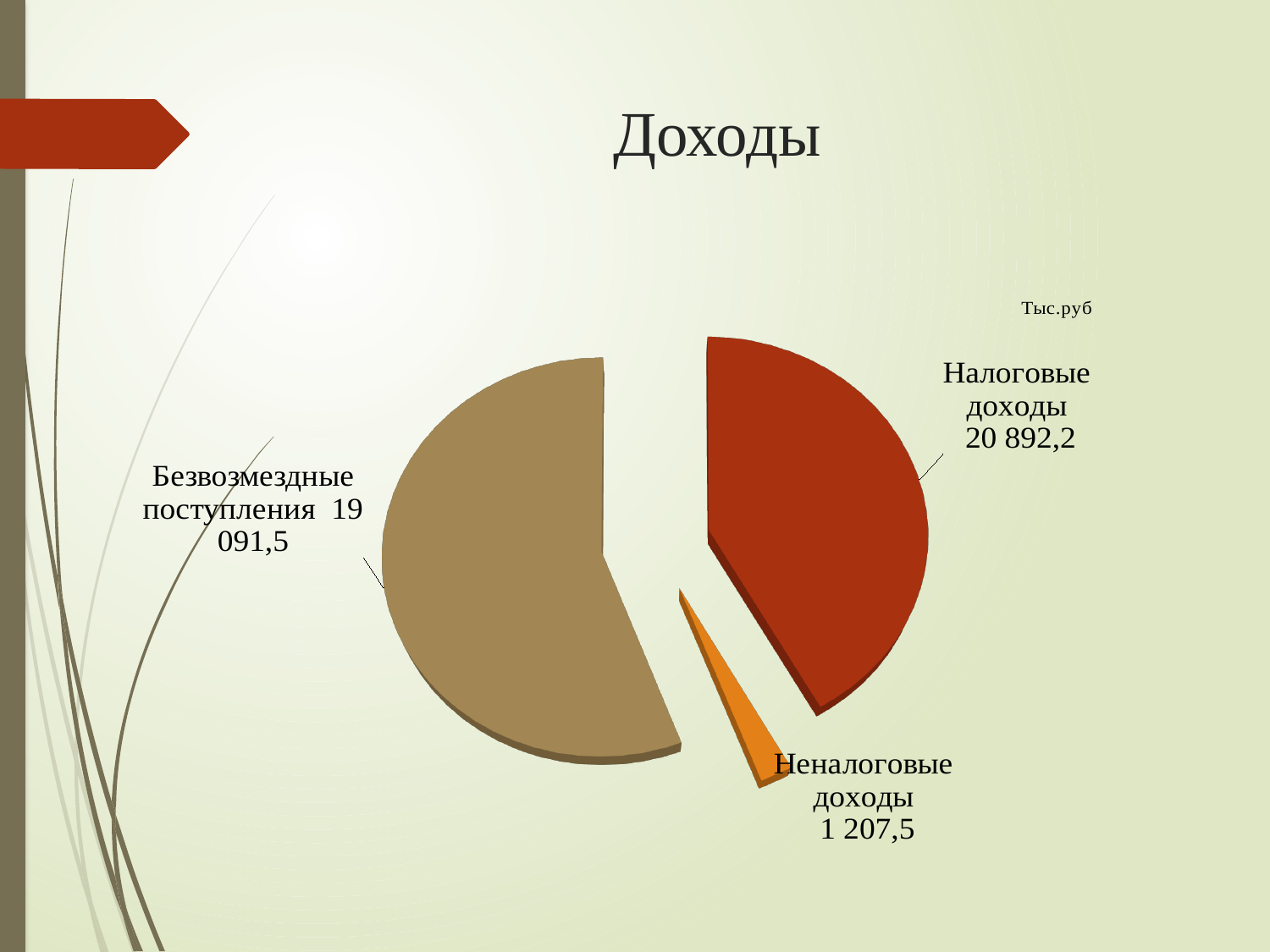
Which is larger, Налоговые доходы or Неналоговые доходы? Налоговые доходы What kind of chart is shown on the slide? Pie chart What is the title of the chart on the slide? Доходы Which category has the largest slice of the pie? Безвозмездные поступления What is the value for Безвозмездные поступления? 19 091,5 What is the value for Неналоговые доходы? 1 207,5 What is the value for Налоговые доходы? 20 892,2 What is the difference between Безвозмездные поступления and Неналоговые доходы? 17 884,0 In what units are the values on the chart given? Тыс.руб How many slices does the pie chart have? 3 What is the difference between Налоговые доходы and Безвозмездные поступления? 1 800,7 Which category has the smallest slice of the pie? Неналоговые доходы